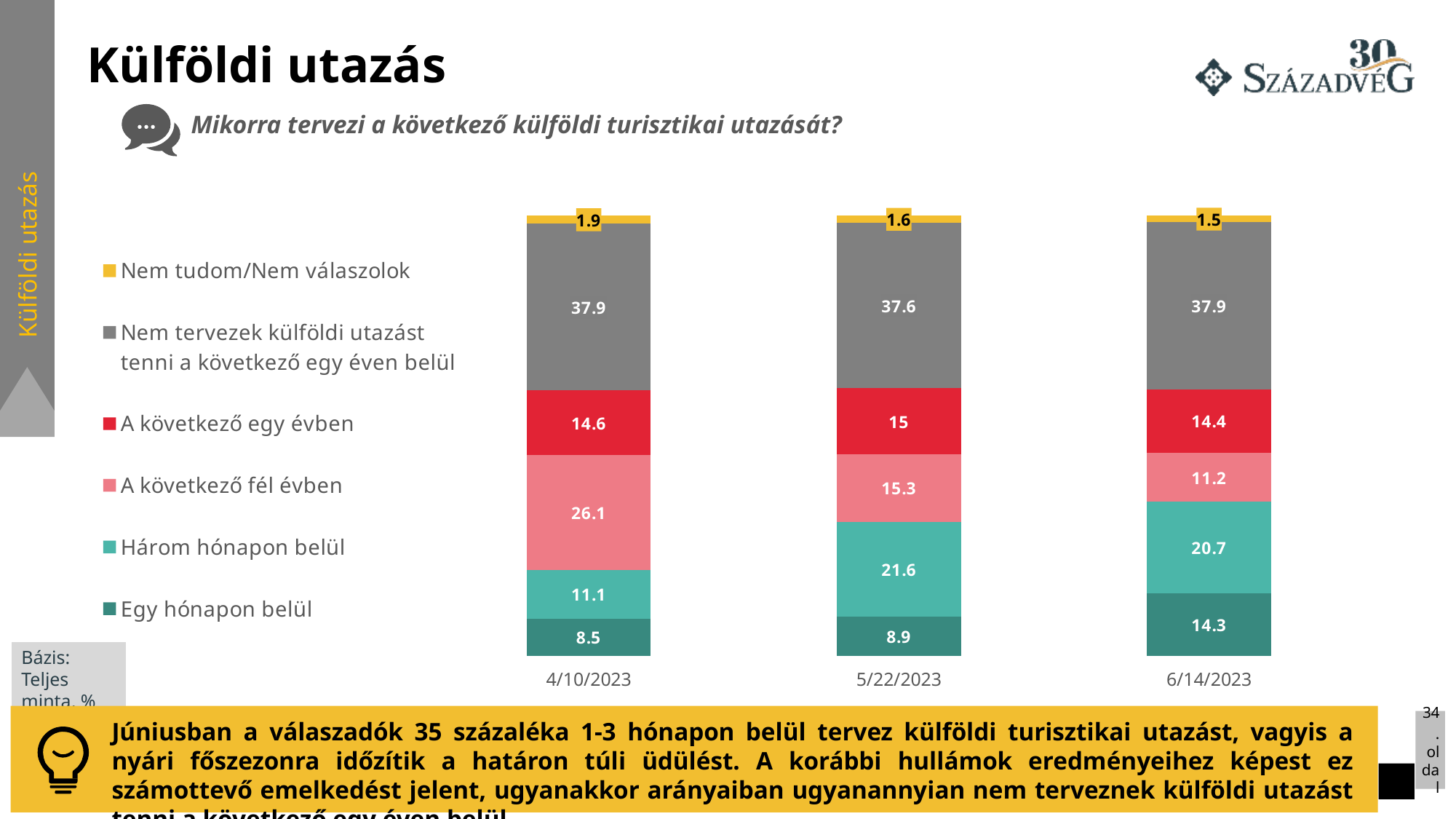
How many dates (bars) are shown on the x axis? 3 What is the value for 'Nem tudom/Nem válaszolok' on 5/22/2023? 1.6 On which date is the value for 'Egy hónapon belül' the highest? 6/14/2023 What is the difference between the 'A következő fél évben' values on 4/10/2023 and 6/14/2023? 14.9 On which date is the value for 'Három hónapon belül' the lowest? 4/10/2023 What is the value for 'Három hónapon belül' on 5/22/2023? 21.6 Which is larger on 5/22/2023: 'A következő egy évben' or 'A következő fél évben'? A következő fél évben What type of chart is shown on the slide? stacked bar chart What is the value for 'Egy hónapon belül' on 6/14/2023? 14.3 How many series does the legend list? 6 What is the total of the stacked bar for 5/22/2023? 100 What is the value for 'A következő fél évben' on 4/10/2023? 26.1